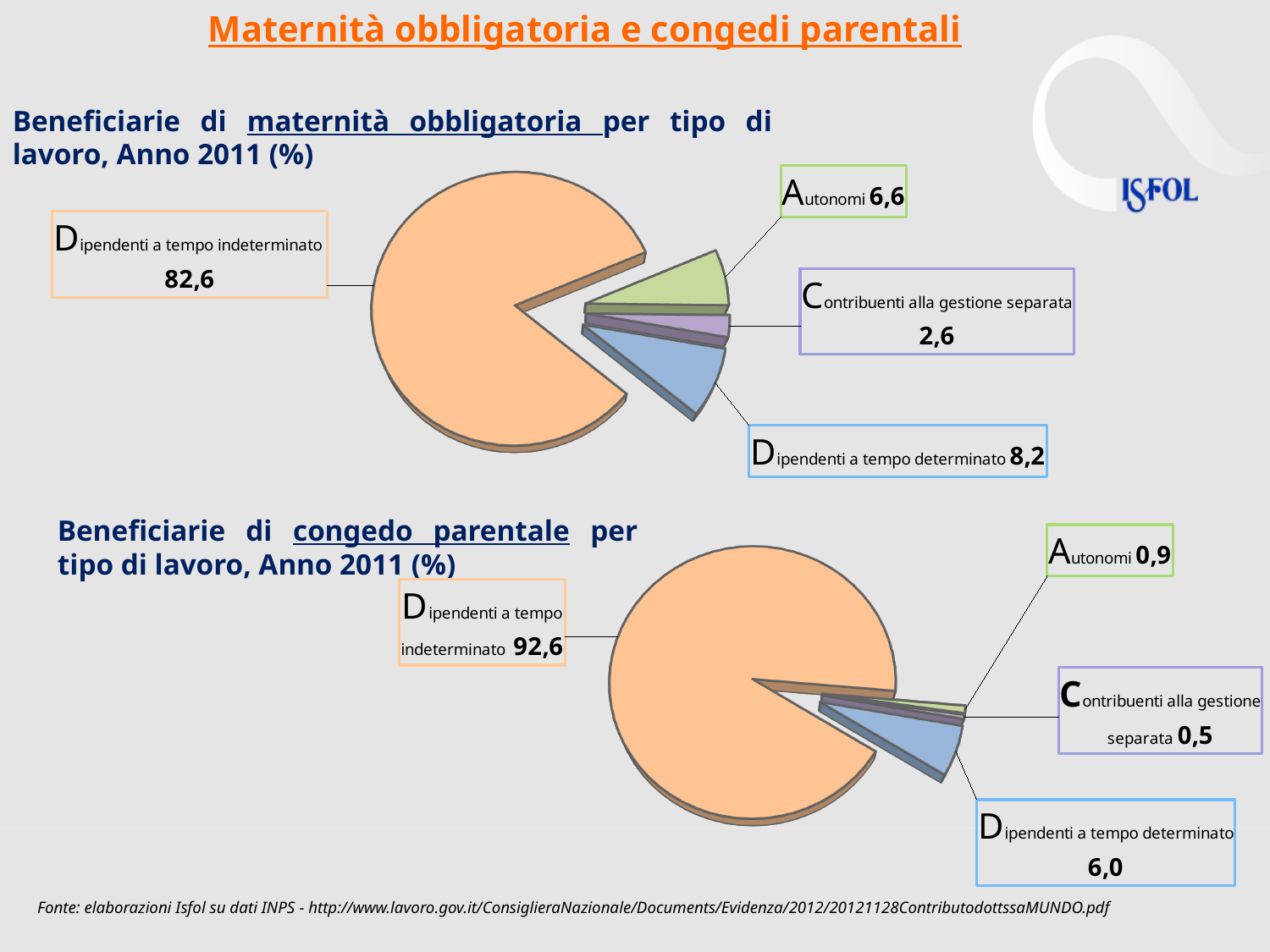
In the bottom chart (congedo parentale), what is the value for Dipendenti a tempo determinato? 6,0 In the top chart (maternità obbligatoria), what is the value for Dipendenti a tempo indeterminato? 82,6 In the top chart (maternità obbligatoria), what is the difference between Dipendenti a tempo determinato and Autonomi? 1,6 In the bottom chart (congedo parentale), what is the value for Dipendenti a tempo indeterminato? 92,6 In the top chart (maternità obbligatoria), what is the value for Contribuenti alla gestione separata? 2,6 How many categories does the top chart (maternità obbligatoria) show? 4 In the bottom chart (congedo parentale), which is larger: Autonomi or Contribuenti alla gestione separata? Autonomi In the top chart (maternità obbligatoria), what is the value for Autonomi? 6,6 In the top chart (maternità obbligatoria), which category has the smallest slice? Contribuenti alla gestione separata In the bottom chart (congedo parentale), which category has the largest slice? Dipendenti a tempo indeterminato What is the difference between the Dipendenti a tempo indeterminato values in the bottom chart (congedo parentale) and the top chart (maternità obbligatoria)? 10,0 What kind of chart is the bottom chart (congedo parentale)? Pie chart